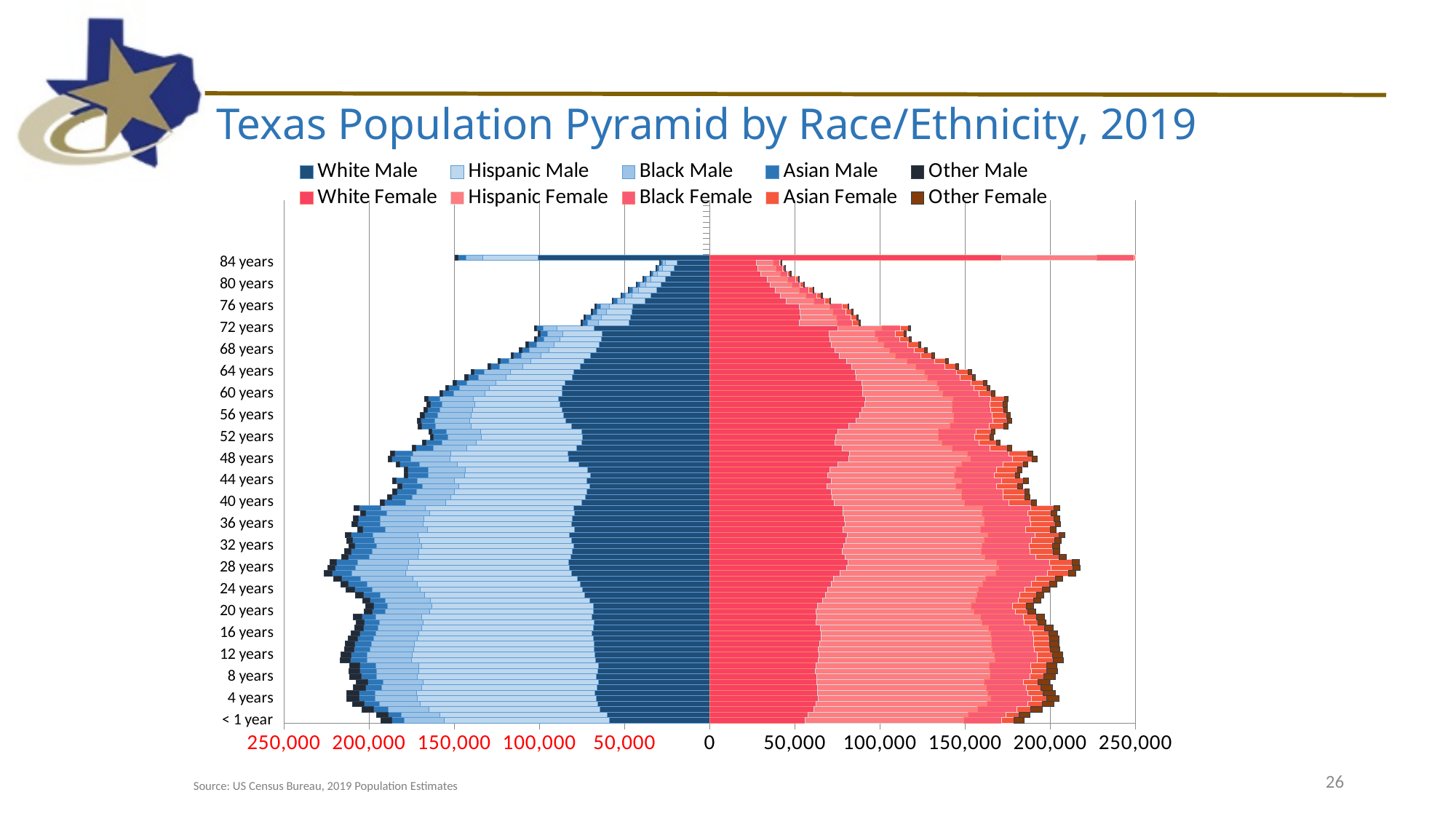
Is the total female bar for 72 years greater or less than 150,000? less How many series does the legend list? 10 Is the total male bar for 60 years greater or less than 200,000? less What kind of chart is shown on the slide? Bar chart (population pyramid) Which is longer, the total male bar for 28 years or the total male bar for 72 years? 28 years Which series are listed in the legend for males? White Male, Hispanic Male, Black Male, Asian Male, Other Male What is the largest value shown on the horizontal axis? 250,000 Which is longer, the total male bar or the total female bar for 84 years? Female Is the total male bar for 28 years greater or less than 200,000? greater What is the title of the chart? Texas Population Pyramid by Race/Ethnicity, 2019